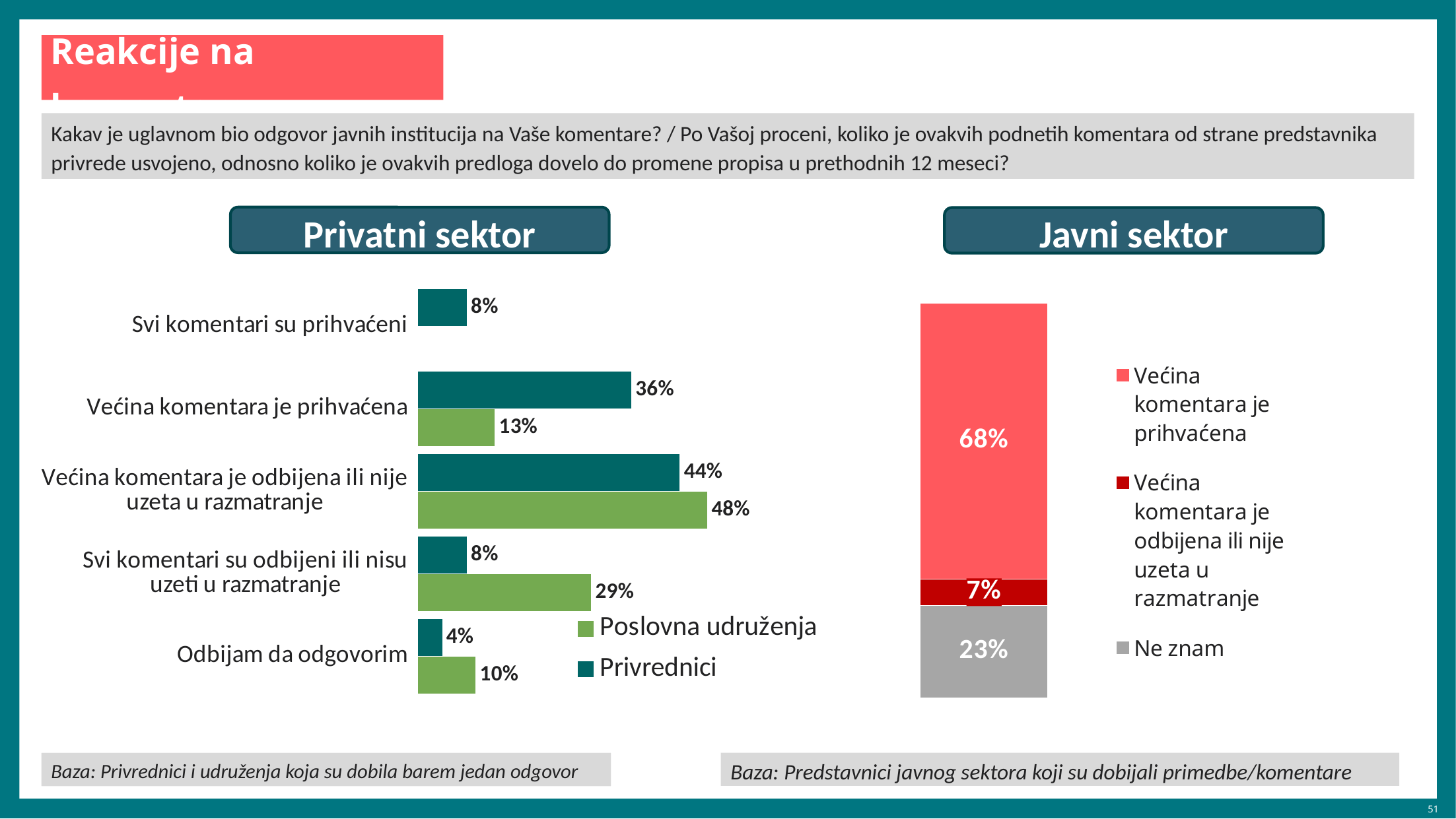
In the 'Privatni sektor' chart, what is the value for Poslovna udruženja for 'Odbijam da odgovorim'? 10% How many series does the legend of the 'Privatni sektor' chart list? 2 In the 'Privatni sektor' chart, which category has the lowest value for Privrednici? Odbijam da odgovorim In the 'Javni sektor' chart, what is the difference between 'Ne znam' and 'Većina komentara je odbijena ili nije uzeta u razmatranje'? 16 percentage points In the 'Privatni sektor' chart, what is the value for Poslovna udruženja for 'Svi komentari su odbijeni ili nisu uzeti u razmatranje'? 29% In the 'Privatni sektor' chart, what is the value for Privrednici for 'Većina komentara je prihvaćena'? 36% How many categories are shown in the 'Privatni sektor' chart? 5 In the 'Privatni sektor' chart, what is the difference between Privrednici and Poslovna udruženja for 'Većina komentara je prihvaćena'? 23 percentage points What kind of chart is the 'Privatni sektor' chart? Bar chart In the 'Privatni sektor' chart, which category has the highest value for Poslovna udruženja? Većina komentara je odbijena ili nije uzeta u razmatranje In the 'Javni sektor' chart, what is the value for 'Većina komentara je prihvaćena'? 68% In the 'Privatni sektor' chart, for 'Većina komentara je odbijena ili nije uzeta u razmatranje', which series has the larger value, Privrednici or Poslovna udruženja? Poslovna udruženja